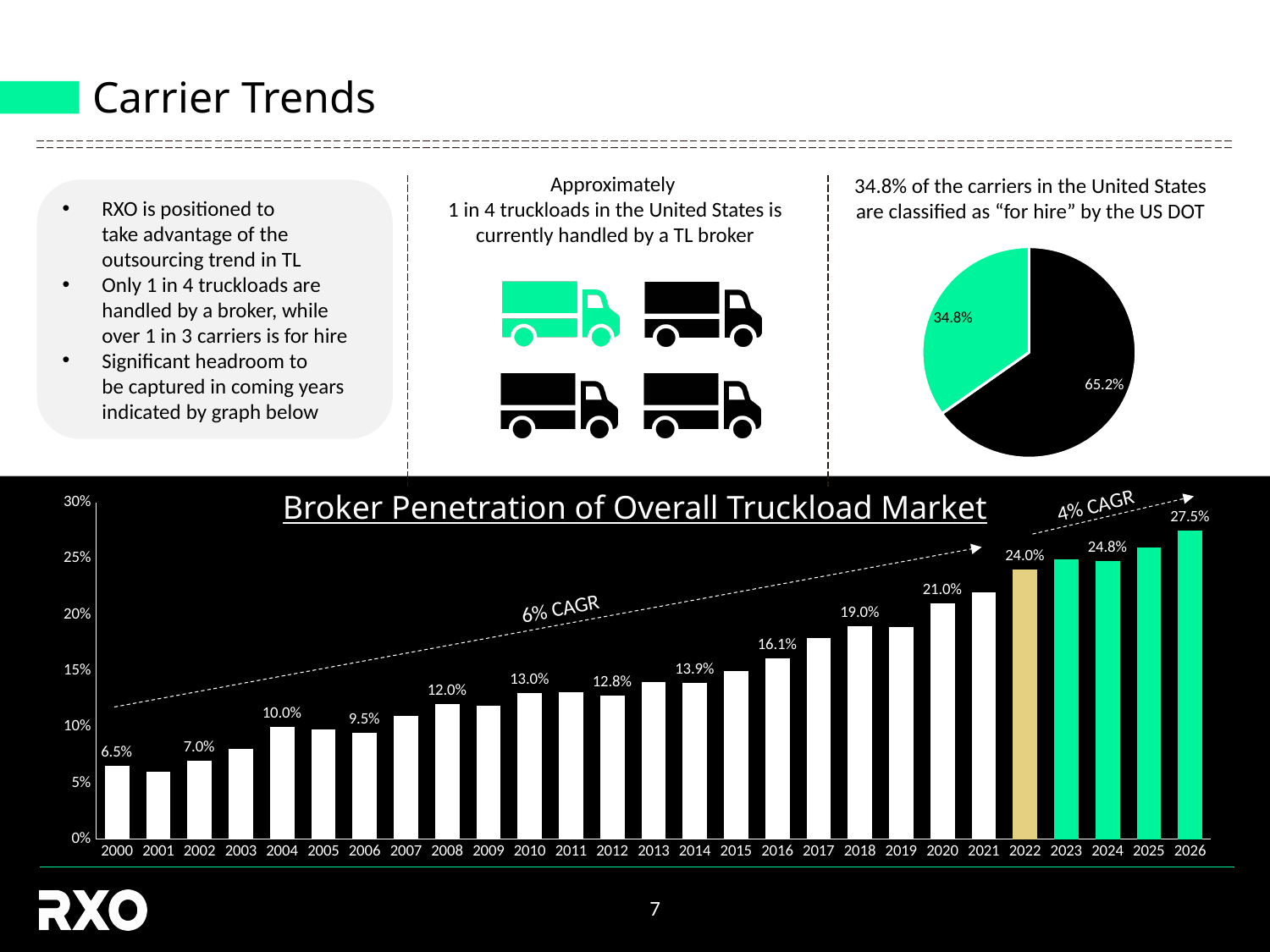
In the Broker Penetration of Overall Truckload Market chart, which year has the highest value? 2026 In the Broker Penetration of Overall Truckload Market chart, what is the value for 2000? 6.5% In the pie chart on the right, what share of carriers is classified as "for hire"? 34.8% In the Broker Penetration of Overall Truckload Market chart, is the value for 2001 greater or less than 10%? less In the Broker Penetration of Overall Truckload Market chart, which is larger, the value for 2010 or the value for 2012? 2010 How many years are shown on the x axis of the Broker Penetration of Overall Truckload Market chart? 27 What kind of chart is the Broker Penetration of Overall Truckload Market chart? Bar chart In the Broker Penetration of Overall Truckload Market chart, do the values generally rise or fall from 2000 to 2026? Rise In the Broker Penetration of Overall Truckload Market chart, is the value for 2017 greater or less than 15%? greater In the Broker Penetration of Overall Truckload Market chart, what is the value for 2026? 27.5% In the Broker Penetration of Overall Truckload Market chart, what is the difference between the 2022 value and the 2000 value? 17.5% In the Broker Penetration of Overall Truckload Market chart, what is the value for 2018? 19.0%